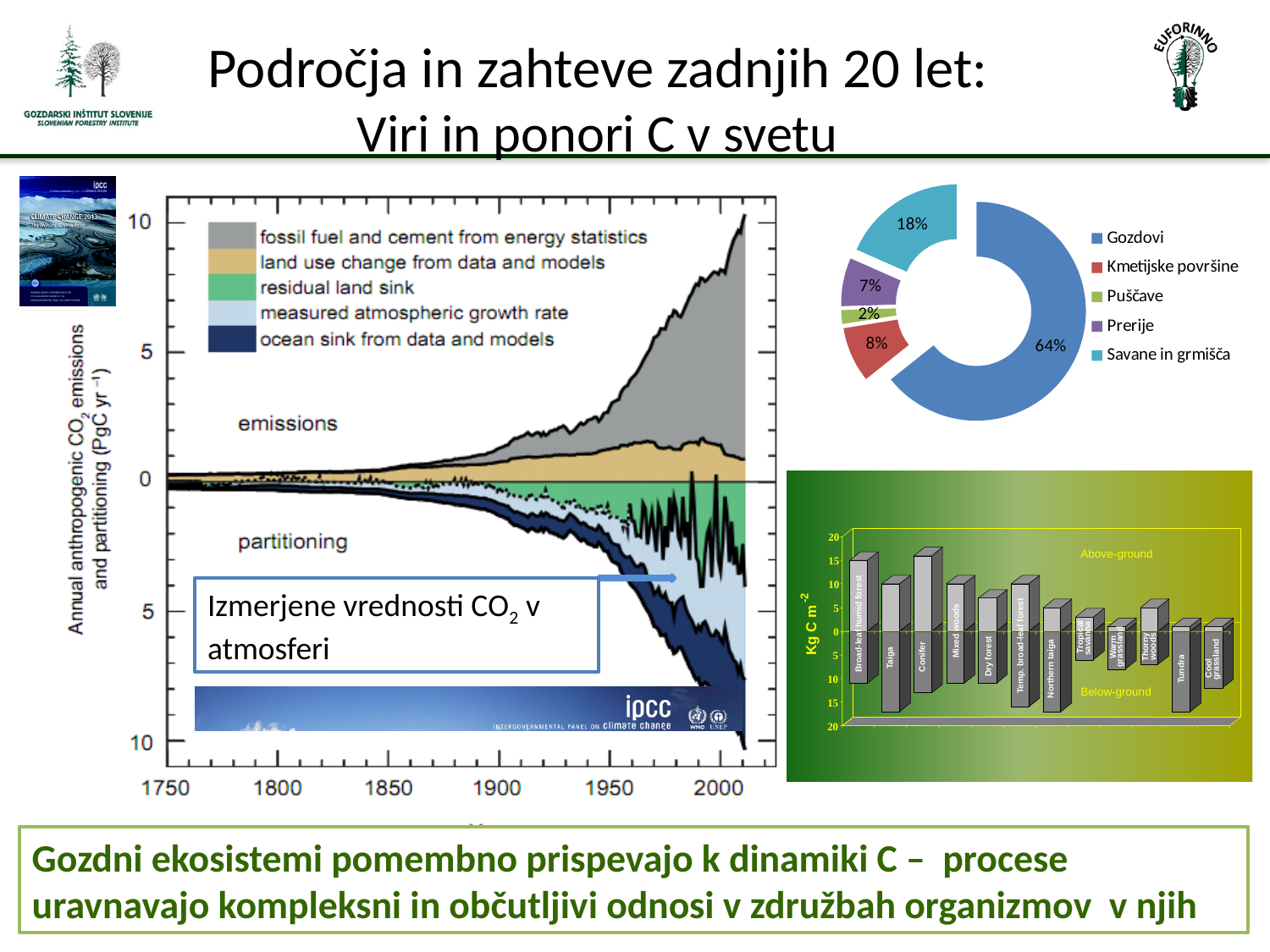
In the doughnut chart at the top right, what percentage is shown for Puščave? 2% In the doughnut chart at the top right, which category has the smallest share? Puščave In the doughnut chart at the top right, how many categories does the legend list? 5 In the doughnut chart at the top right, what is the difference in percentage points between Gozdovi and Savane in grmišča? 46 percentage points What kind of chart is the one at the bottom right showing Above-ground and Below-ground values? Bar chart In the bar chart at the bottom right, is the above-ground value for Tundra greater or less than 5? less In the doughnut chart at the top right, what percentage is shown for Gozdovi? 64% In the doughnut chart at the top right, what percentage is shown for Savane in grmišča? 18% In the IPCC chart on the left, what year does the x axis start at? 1750 In the doughnut chart at the top right, which is larger, Kmetijske površine or Prerije? Kmetijske površine In the IPCC chart on the left, how many series does the legend list? 5 In the doughnut chart at the top right, which category has the largest share? Gozdovi